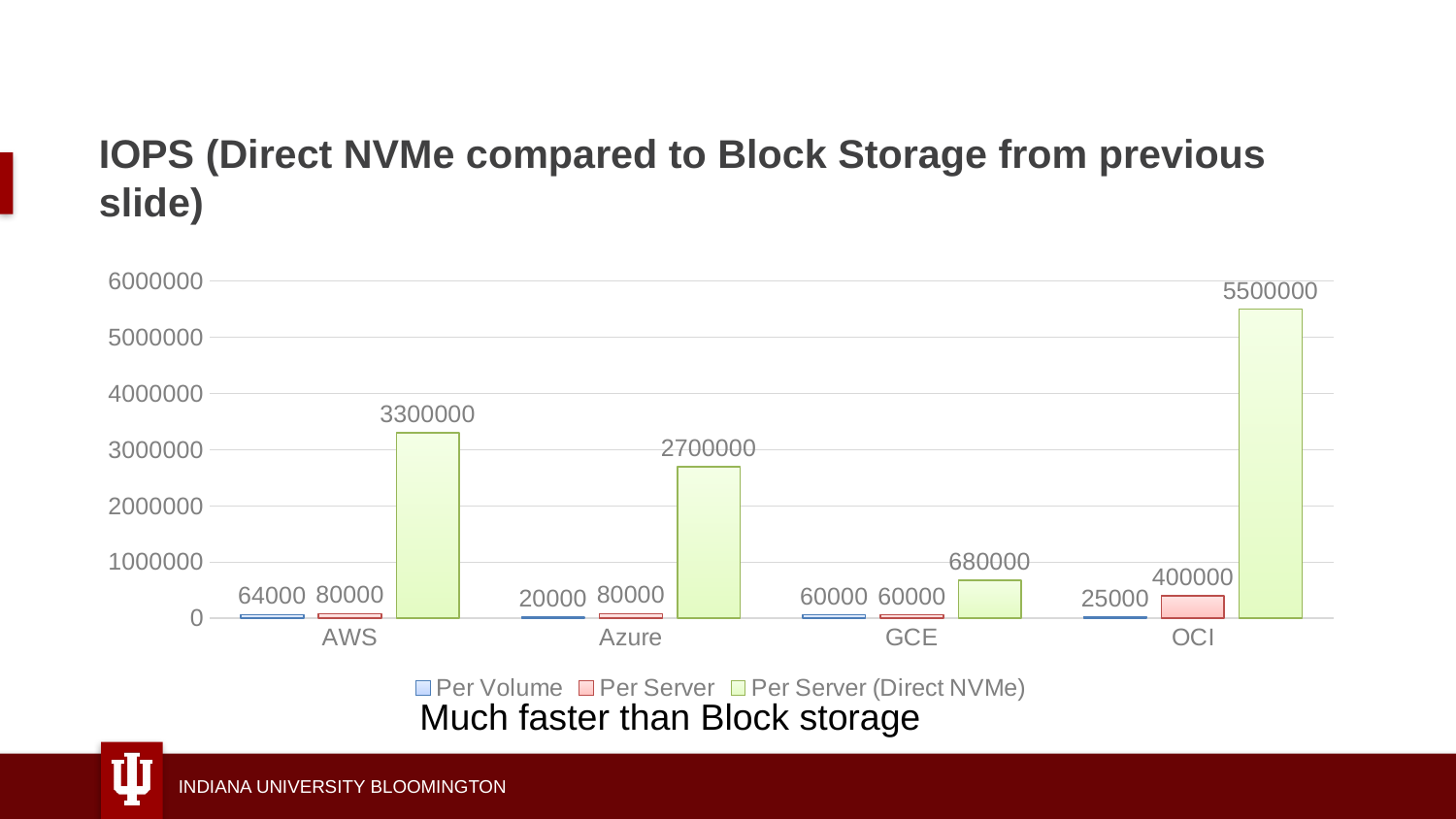
What is the Per Server (Direct NVMe) value for GCE? 680000 Which provider has the lowest Per Server (Direct NVMe) value? GCE Which is larger, the Per Server (Direct NVMe) value for AWS or for Azure? AWS What kind of chart is shown on the slide? bar chart What is the Per Server (Direct NVMe) value for OCI? 5500000 Is the Per Server (Direct NVMe) value for Azure greater or less than 3000000? less How many providers are shown on the x axis? 4 What is the Per Server value for Azure? 80000 Which provider has the highest Per Server (Direct NVMe) value? OCI What is the Per Volume value for AWS? 64000 What is the difference between the Per Server (Direct NVMe) values for OCI and AWS? 2200000 How many series does the legend list? 3